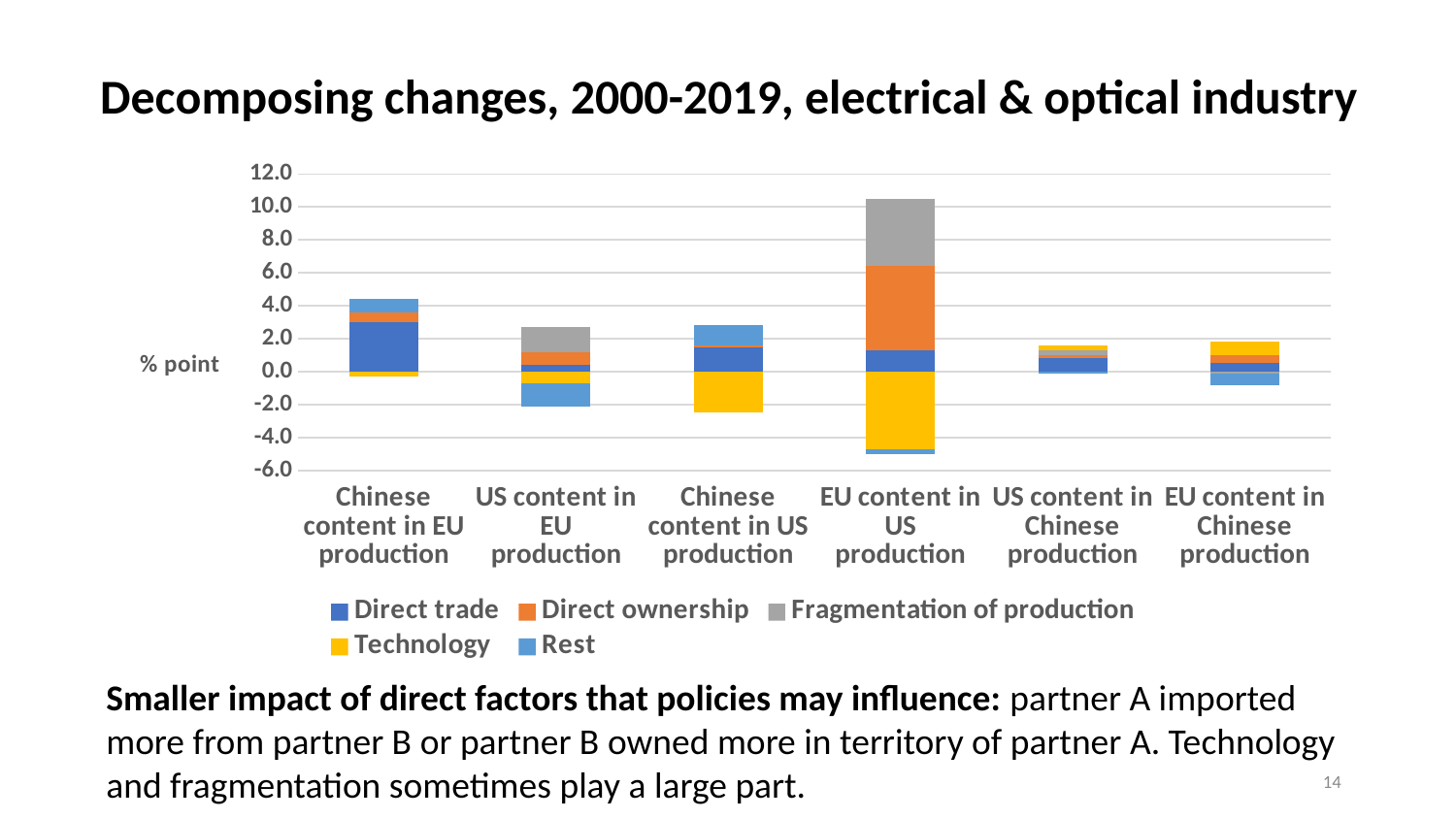
Which category has the tallest positive stacked bar? EU content in US production Is the bottom of the negative stack for EU content in US production greater or less than -4.0? less What is the label on the vertical axis of the chart? % point What is the title of the chart on the slide? Decomposing changes, 2000-2019, electrical & optical industry Is the Direct ownership segment for EU content in US production larger or smaller than the Direct ownership segment for US content in EU production? larger How many categories are shown on the x axis of the chart? 6 What kind of chart is shown on the slide? Stacked bar chart How many series does the chart's legend list? 5 Which category has the largest Fragmentation of production segment? EU content in US production Is the top of the positive stack for EU content in US production greater or less than 8.0? greater Is the Direct trade segment for Chinese content in EU production greater or less than 2.0? greater Which category has the largest Direct trade segment? Chinese content in EU production